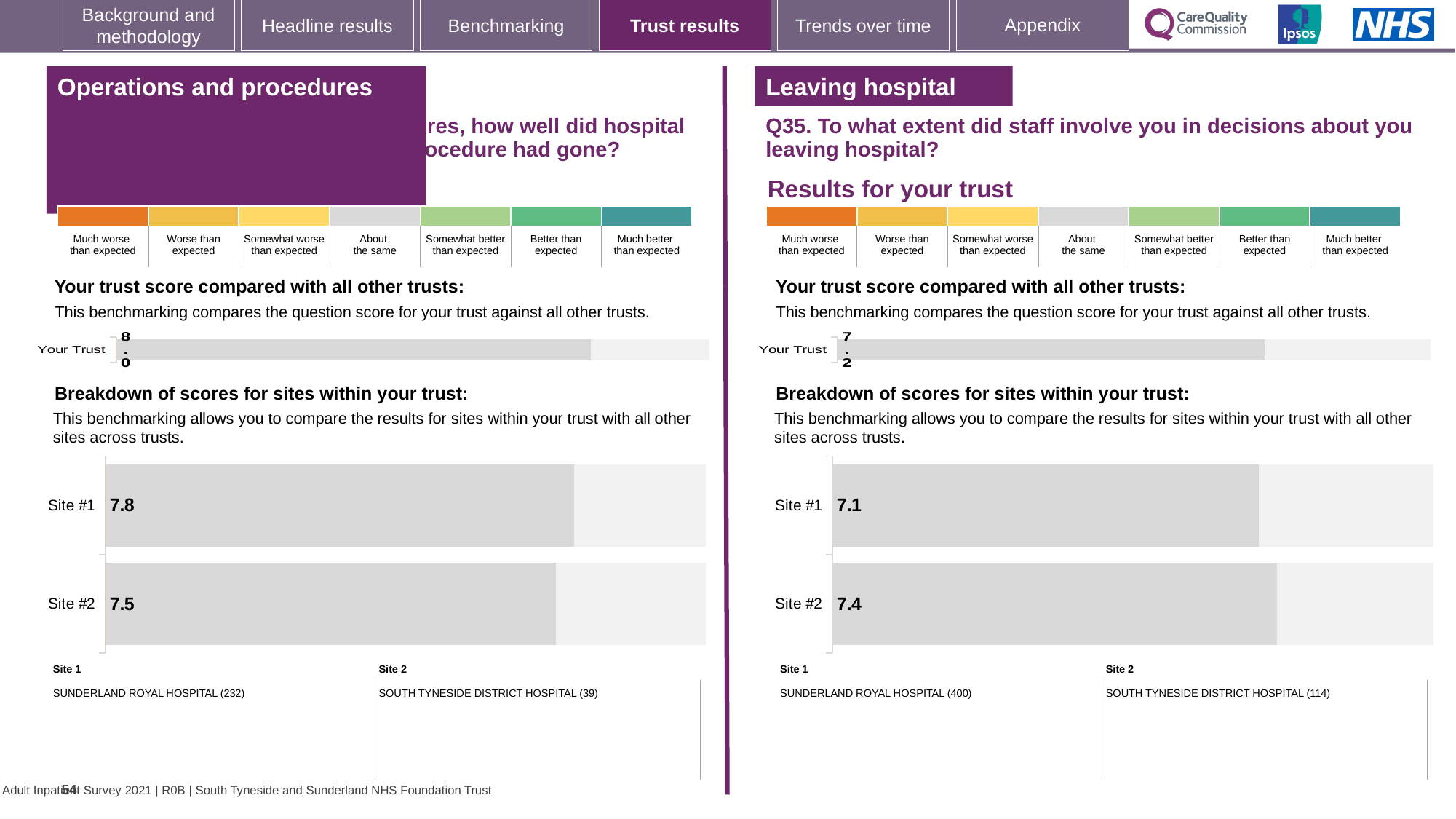
In the Leaving hospital site breakdown chart, what is the score for Site #2? 7.4 How many sites are shown in the Leaving hospital site breakdown chart? 2 In the Operations and procedures site breakdown chart, what is the score for Site #1? 7.8 In the Operations and procedures site breakdown chart, which site has the higher score? Site #1 In the Leaving hospital site breakdown chart, which site has the lower score? Site #1 What kind of chart is used for the site breakdown in the Operations and procedures section? Bar chart In the Leaving hospital section, what is the score shown for Your Trust? 7.2 In the Leaving hospital site breakdown chart, what is the difference between the Site #2 and Site #1 scores? 0.3 In the Operations and procedures site breakdown chart, what is the score for Site #2? 7.5 In the Leaving hospital site breakdown chart, what is the score for Site #1? 7.1 In the Operations and procedures site breakdown chart, what is the difference between the Site #1 and Site #2 scores? 0.3 In the Operations and procedures section, what is the score shown for Your Trust? 8.0